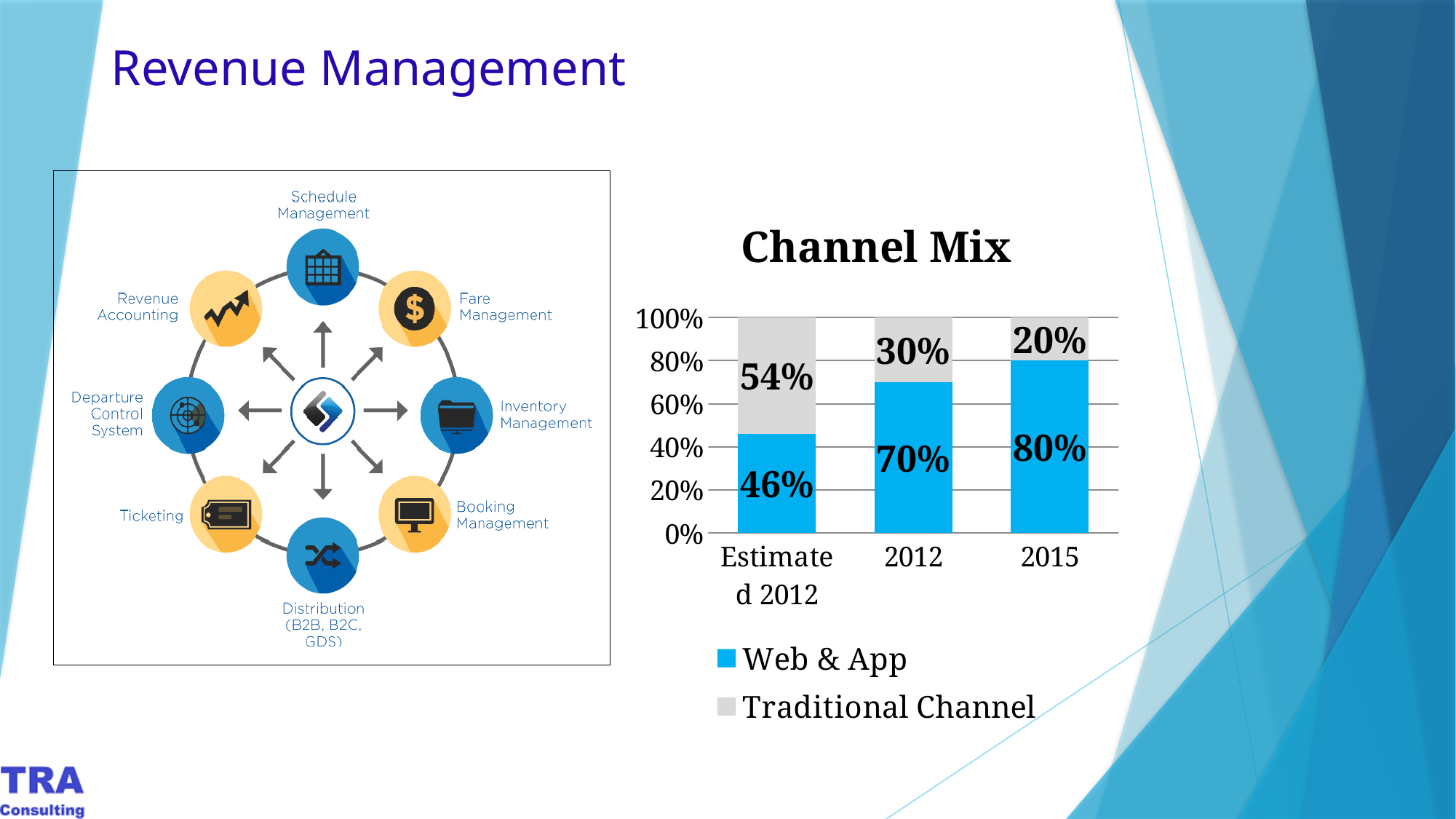
What kind of chart is shown under the title 'Channel Mix'? stacked bar chart Does the Web & App value rise or fall from Estimated 2012 to 2015? rise What is the title of the chart? Channel Mix Which category has the highest Web & App value? 2015 What is the Web & App value for 2012? 70% How many series does the legend of the Channel Mix chart list? 2 What is the Traditional Channel value for Estimated 2012? 54% How many categories are shown on the x axis of the Channel Mix chart? 3 What is the Traditional Channel value for 2015? 20% Which category has the lowest Traditional Channel value? 2015 What is the difference between the Web & App values for 2015 and Estimated 2012? 34% What is the Web & App value for 2015? 80%